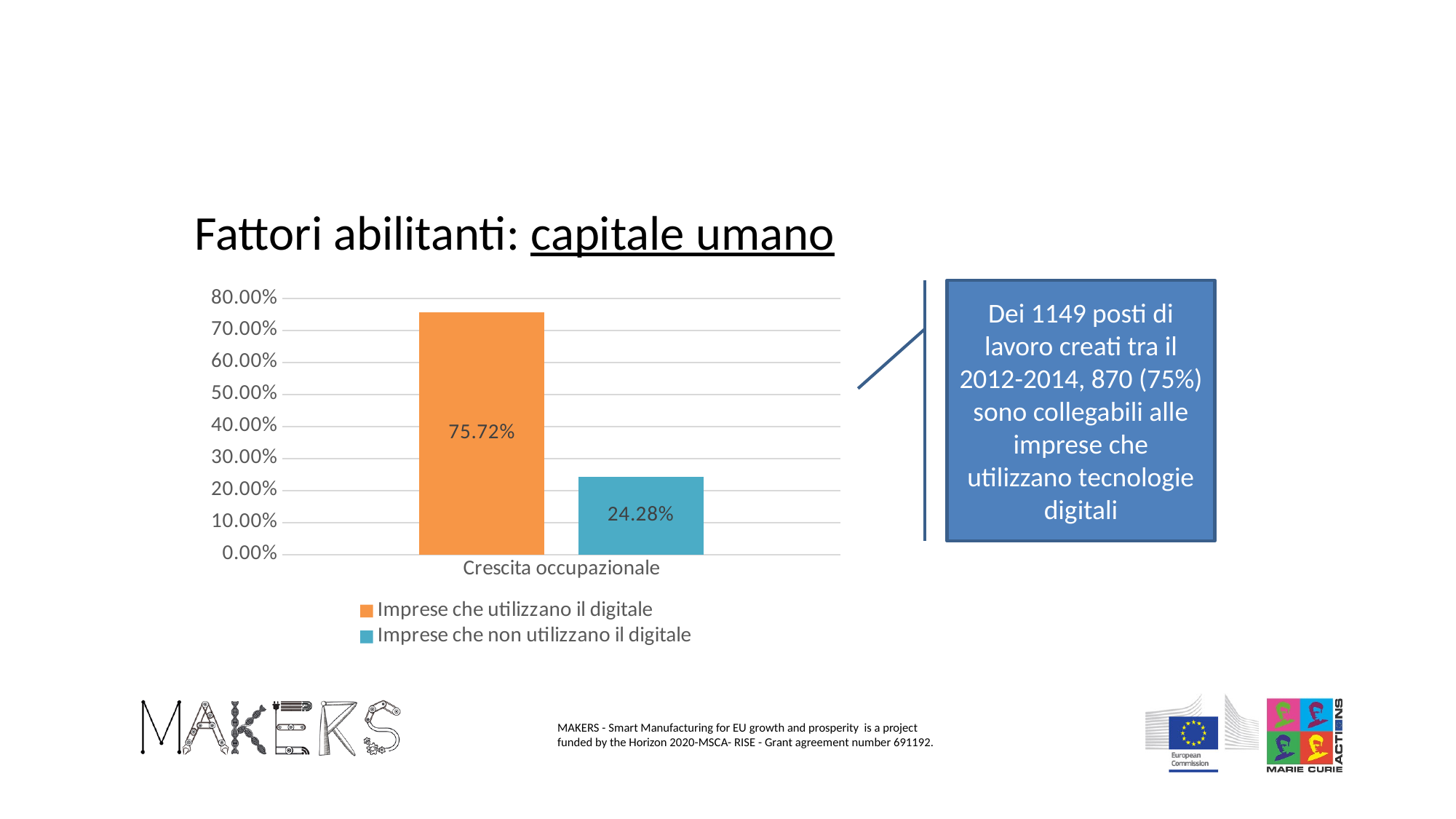
What colour is the bar for 'Imprese che non utilizzano il digitale'? blue (teal) Which series has the lower value in the Crescita occupazionale chart? Imprese che non utilizzano il digitale What is the difference between the values for 'Imprese che utilizzano il digitale' and 'Imprese che non utilizzano il digitale'? 51.44% What is the value for 'Imprese che non utilizzano il digitale' in the Crescita occupazionale chart? 24.28% How many series does the legend list? 2 Which series has the higher value in the Crescita occupazionale chart? Imprese che utilizzano il digitale What is the category label on the x axis of the chart? Crescita occupazionale Is the value for 'Imprese che utilizzano il digitale' larger or smaller than the value for 'Imprese che non utilizzano il digitale'? larger What is the value for 'Imprese che utilizzano il digitale' in the Crescita occupazionale chart? 75.72% Is the value for 'Imprese che non utilizzano il digitale' greater or less than 30.00%? less What kind of chart is shown on the slide? bar chart Is the value for 'Imprese che utilizzano il digitale' greater or less than 70.00%? greater